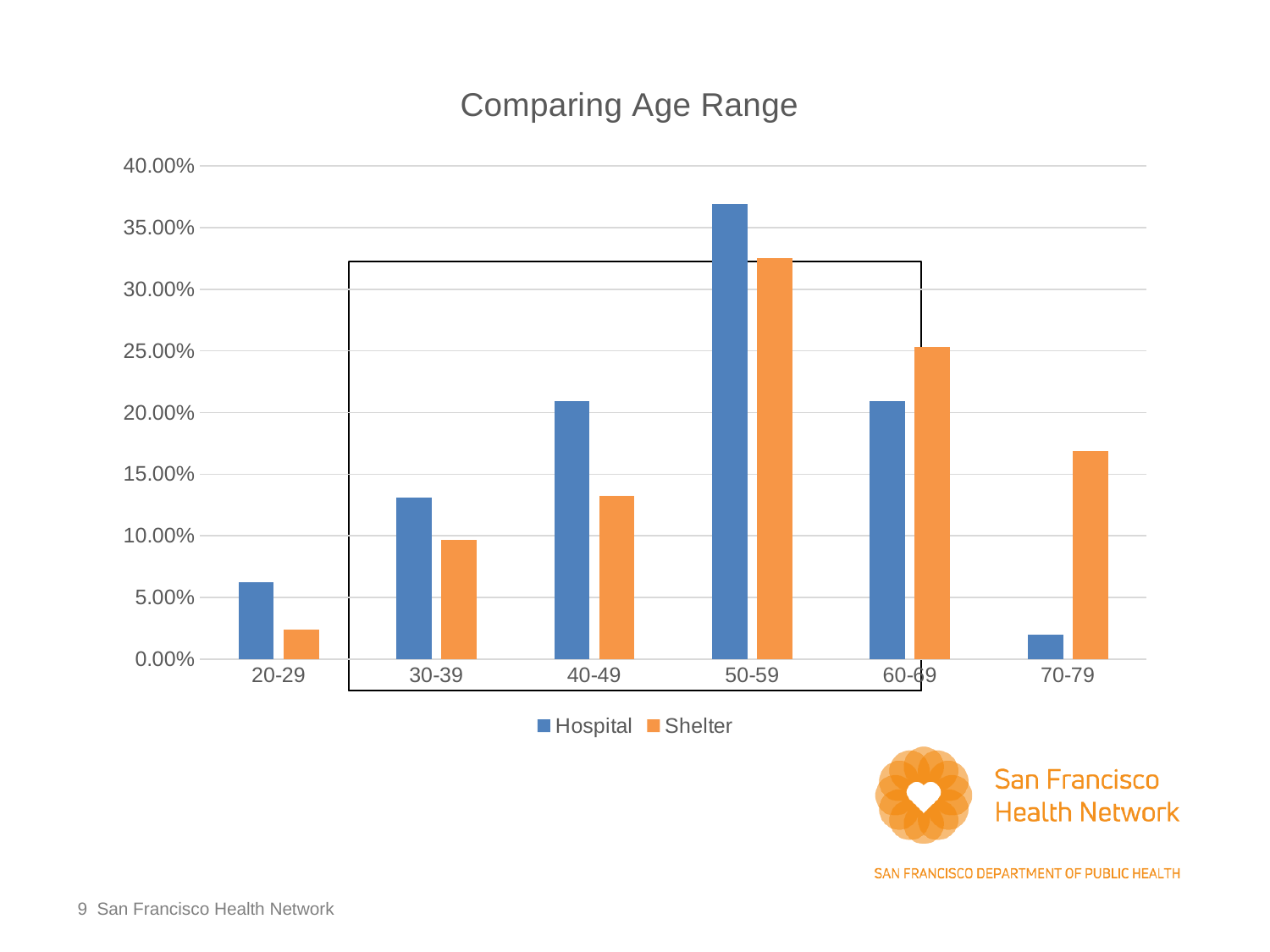
Which age range has the highest Shelter value? 50-59 Is the Hospital value for 50-59 greater or less than 35.00%? greater Which age range has the lowest Hospital value? 70-79 How many age range categories are shown on the x axis? 6 Is the Hospital value for 70-79 greater or less than 5.00%? less What is the title of the chart? Comparing Age Range For the 60-69 age range, which is larger, Hospital or Shelter? Shelter How many series does the legend list? 2 Which age range has the lowest Shelter value? 20-29 Which age range has the highest Hospital value? 50-59 What kind of chart is shown on the slide? bar chart For the 40-49 age range, which is larger, Hospital or Shelter? Hospital